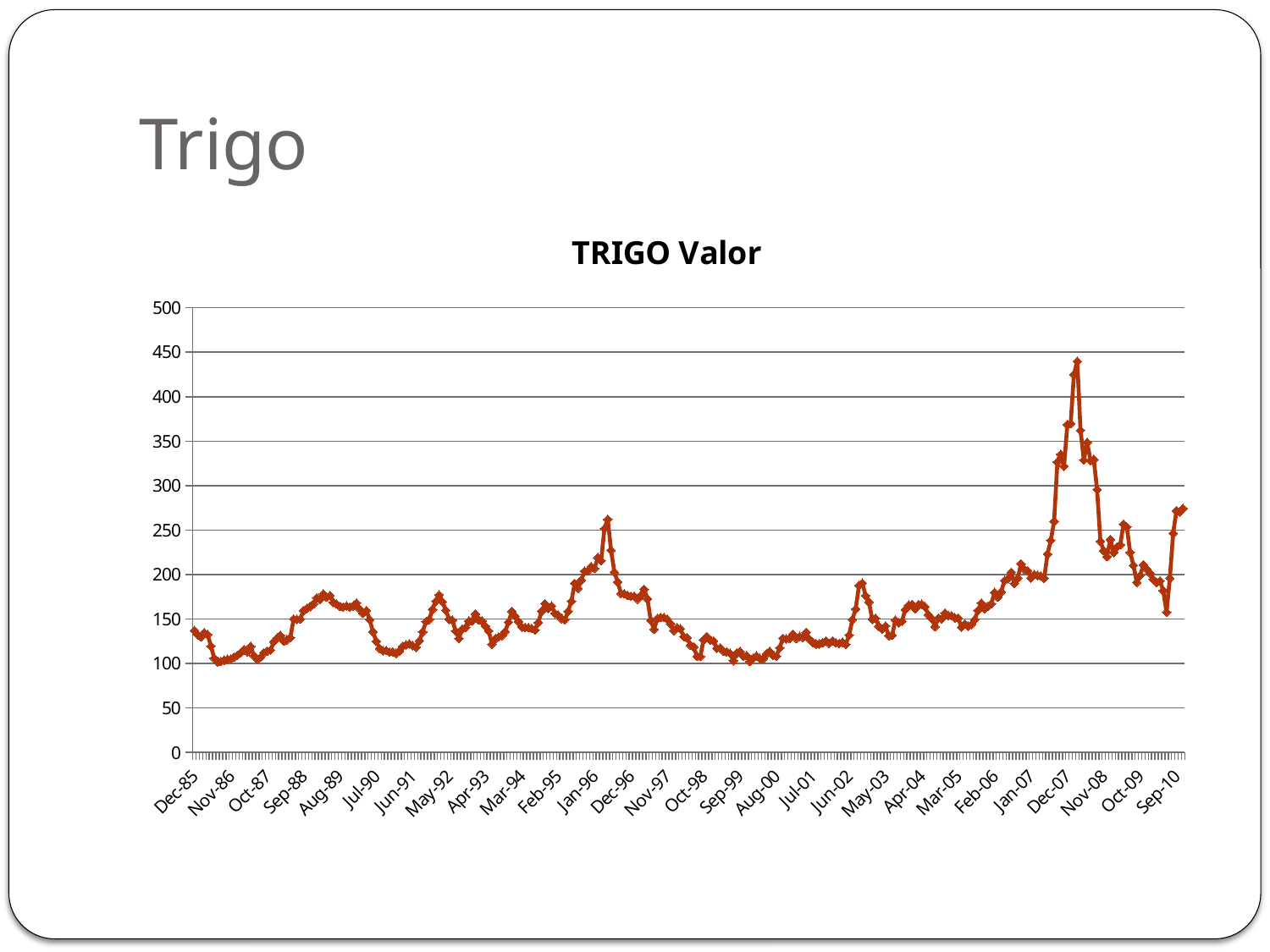
Does the line generally rise or fall between Jun-02 and Dec-07? rise Does the line generally rise or fall between Dec-07 and Oct-09? fall Is the peak near Jan-96 greater or less than 200? greater Which peak is higher, the one near Jan-96 or the one near Dec-07? Dec-07 Is the value at Sep-99 greater or less than 150? less Is the highest peak of the line greater or less than 400? greater Around which x-axis label does the line reach its highest peak? Dec-07 What is the first label on the x axis of the chart? Dec-85 What is the highest value shown on the y axis? 500 What is the title of the chart? TRIGO Valor What kind of chart is shown on the slide? line chart